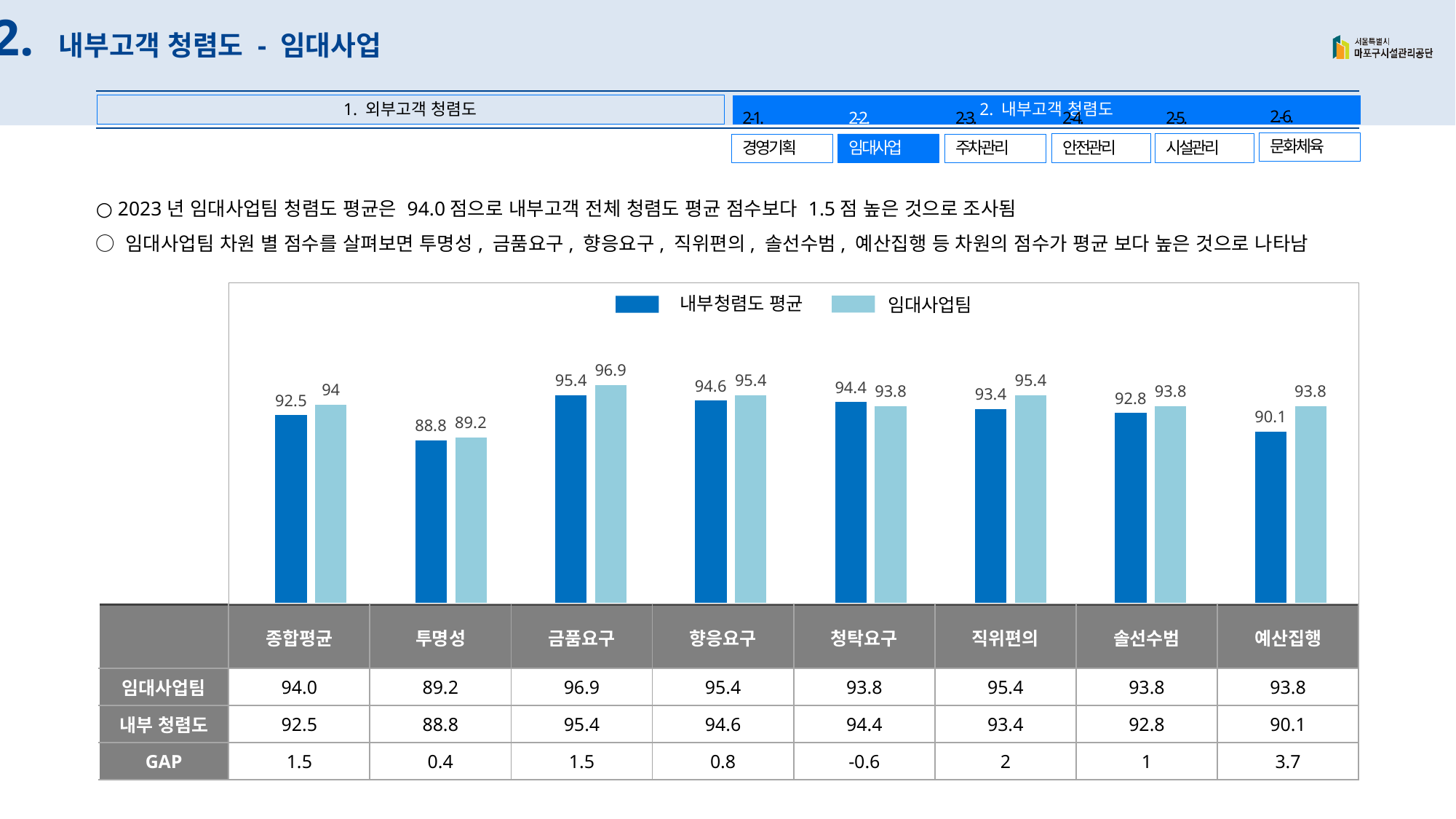
What is the value for 내부청렴도 평균 in the 예산집행 category? 90.1 What kind of chart is shown on the slide? Bar chart What is the difference between the 임대사업팀 and 내부청렴도 평균 values in the 예산집행 category? 3.7 In the 직위편의 category, which series has the larger value, 내부청렴도 평균 or 임대사업팀? 임대사업팀 Which series is shown in light blue in the chart legend? 임대사업팀 Which category has the lowest value for the 내부청렴도 평균 series? 투명성 What is the value for 내부청렴도 평균 in the 투명성 category? 88.8 How many categories are shown on the x axis of the chart? 8 How many series does the chart legend list? 2 What is the value for 임대사업팀 in the 금품요구 category? 96.9 Which category has the highest value for the 임대사업팀 series? 금품요구 In the 청탁요구 category, which series has the larger value, 내부청렴도 평균 or 임대사업팀? 내부청렴도 평균